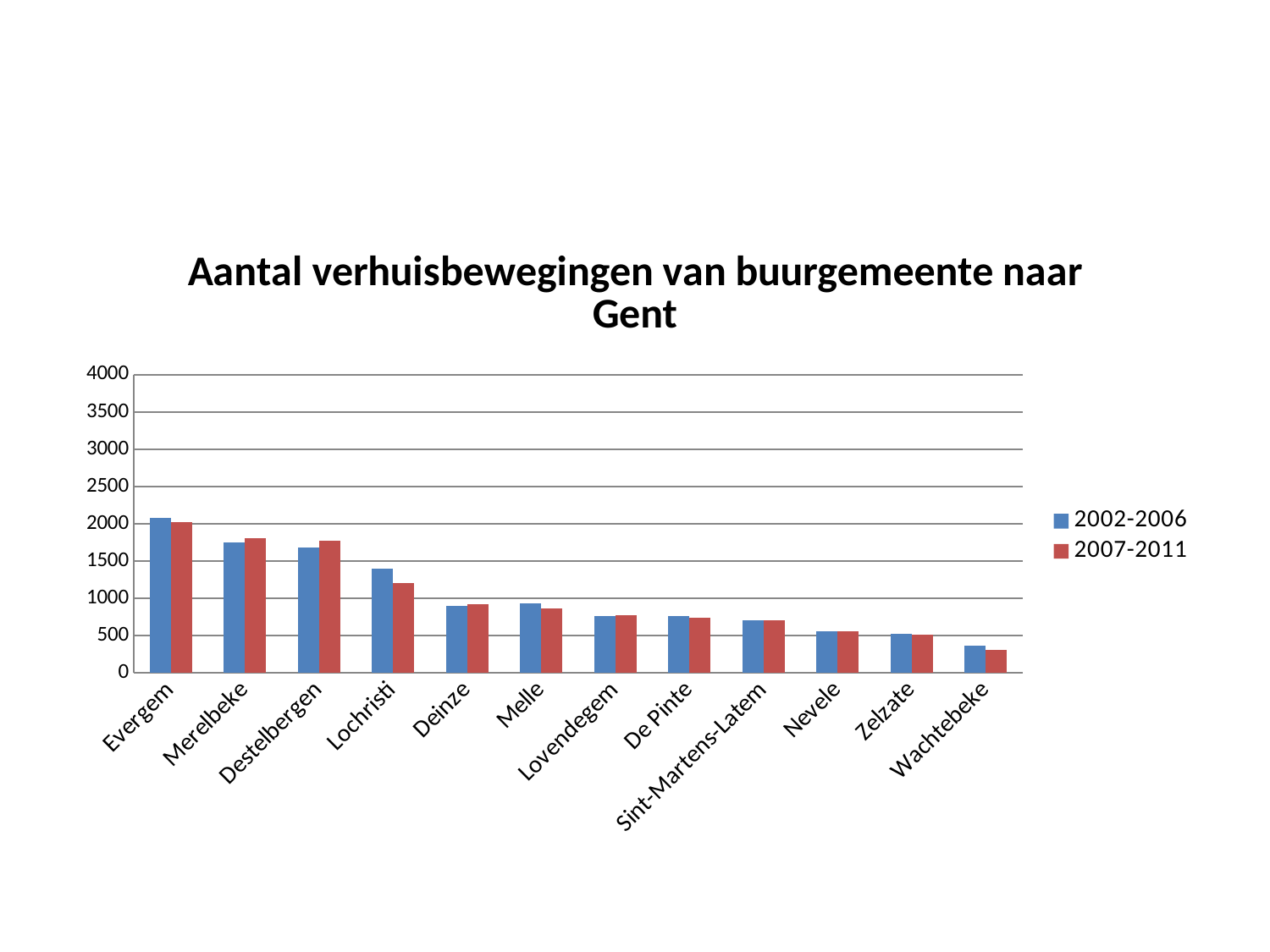
What kind of chart is shown on the slide? bar chart Is the value for Evergem in 2002-2006 greater or less than 1500? greater What is the title of the chart? Aantal verhuisbewegingen van buurgemeente naar Gent For Lochristi, which series has the larger value, 2002-2006 or 2007-2011? 2002-2006 Is the value for Wachtebeke in 2007-2011 greater or less than 500? less For Merelbeke, which series has the larger value, 2002-2006 or 2007-2011? 2007-2011 Is the value for Lochristi in 2007-2011 greater or less than 1500? less Which municipality has the lowest value for 2007-2011? Wachtebeke How many series does the legend list? 2 Do the values for 2002-2006 generally rise or fall from left to right along the x axis? fall Which municipality has the highest value for 2002-2006? Evergem How many municipalities (categories) are shown on the x axis? 12